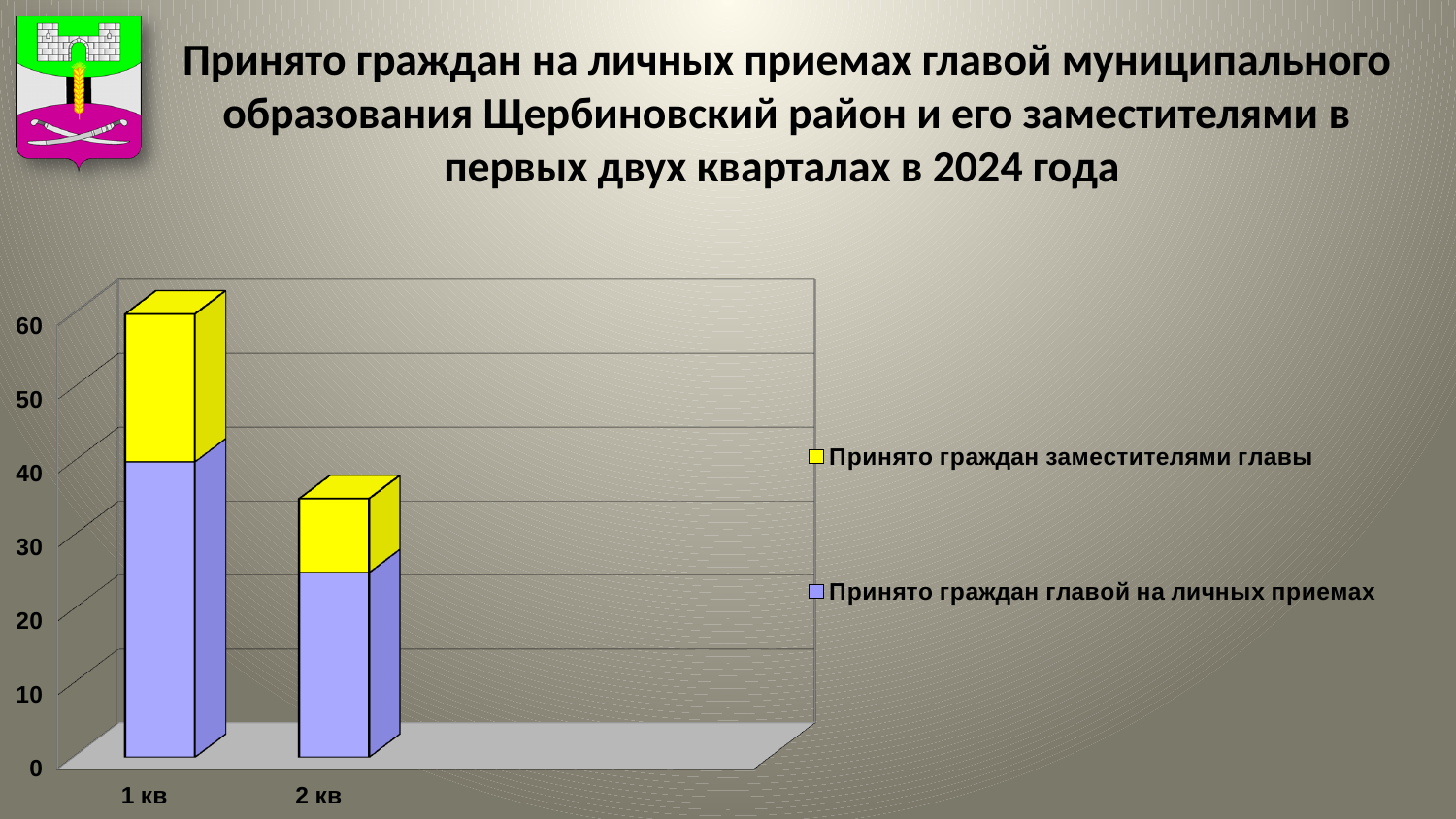
Which category has the taller stacked bar, 1 кв or 2 кв? 1 кв Do the total values rise or fall from 1 кв to 2 кв? fall Which colour represents 'Принято граждан заместителями главы' in the chart? yellow How many categories are shown on the x axis of the chart? 2 Which series is shown in purple in the chart? Принято граждан главой на личных приемах How many series does the chart legend list? 2 Is the value for 'Принято граждан главой на личных приемах' in 2 кв greater or less than 20? greater Is the total stacked bar for 1 кв greater or less than 50? greater Which category has the lowest total stacked bar? 2 кв Is the value for 'Принято граждан главой на личных приемах' in 1 кв greater or less than 30? greater What kind of chart is shown on the slide? bar chart